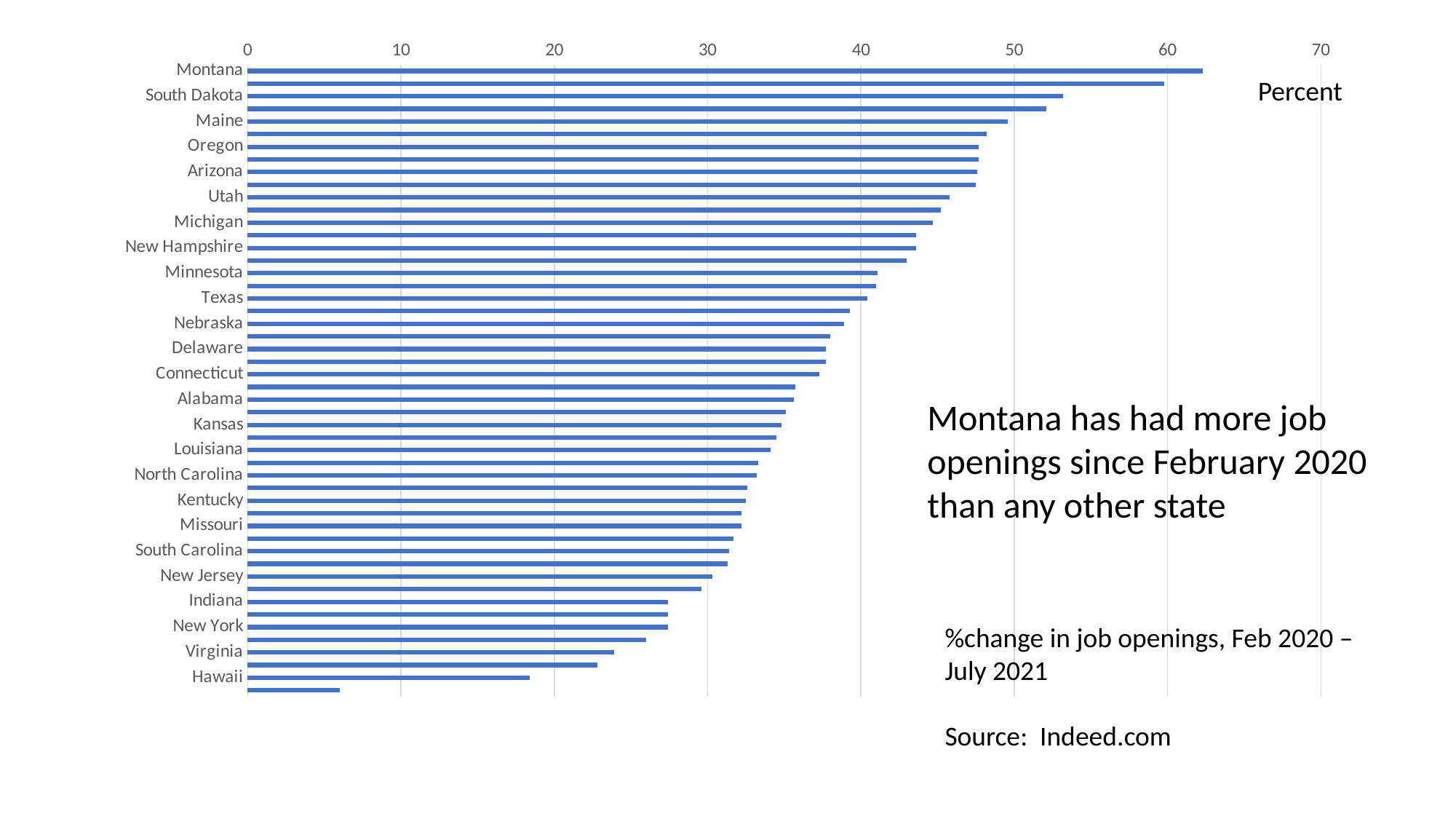
What is the source cited for the chart data? Indeed.com Is the value for Indiana greater or less than 30? less Is the value for Delaware greater or less than 40? less Is the value for South Dakota greater or less than 50? greater Do the bar values rise or fall going from the top of the chart to the bottom? fall Which has a larger value, Maine or New York? Maine What kind of chart is shown on the slide? bar chart Which state has the highest percent change in job openings? Montana Which has a larger value, Texas or Virginia? Texas